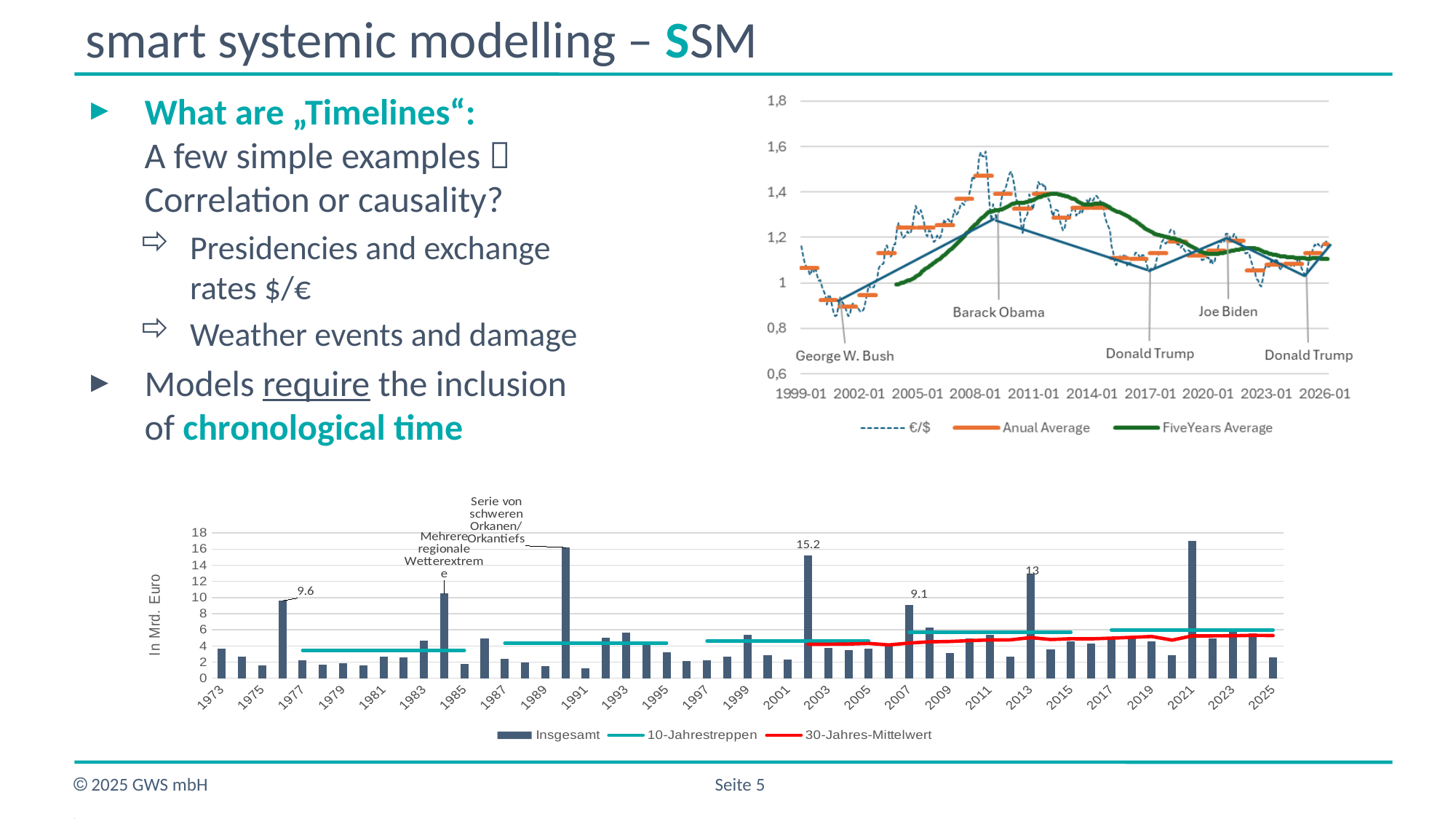
In the bottom chart, what is the labelled value for 2013? 13 In the bottom chart, what is the labelled value for 2007? 9.1 In the top-right exchange rate chart, how many series does the legend list? 3 In the top-right exchange rate chart, is the €/$ value at the 2008 peak greater or less than 1.4? greater In the bottom chart, which is larger, the labelled value for 2002 or for 2013? 2002 In the bottom chart, what is the y-axis label? In Mrd. Euro In the bottom chart, is the value for 2021 greater or less than 16? greater In the bottom chart, what is the difference between the labelled values for 2002 and 2007? 6.1 What kind of chart is the top-right exchange rate chart? line chart In the bottom chart, what is the labelled value for 2002? 15.2 In the bottom chart, how many series does the legend list? 3 In the bottom chart, what is the labelled value for 1976? 9.6